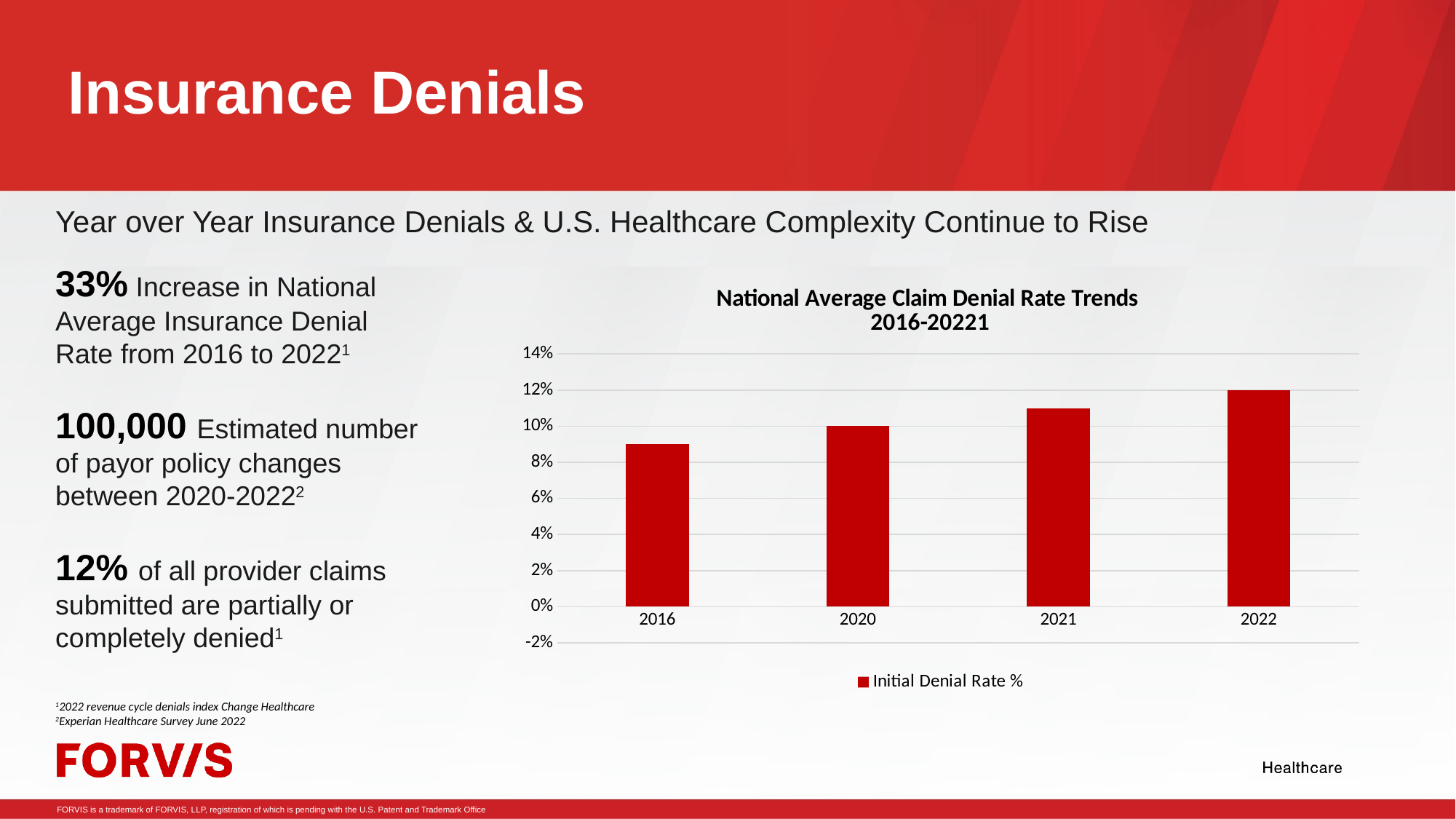
What is the title of the chart? National Average Claim Denial Rate Trends 2016-2022 What is the Initial Denial Rate % for 2020? 10% How many series does the chart legend list? 1 Does the Initial Denial Rate % rise or fall from 2016 to 2022? Rise Which year has the highest Initial Denial Rate %? 2022 What is the name of the series shown in the chart legend? Initial Denial Rate % Which year has the lowest Initial Denial Rate %? 2016 Is the Initial Denial Rate % for 2021 greater or less than 10%? greater Is the Initial Denial Rate % for 2016 greater or less than 10%? less How many years are plotted on the x axis of the chart? 4 What is the Initial Denial Rate % for 2022? 12% What kind of chart is shown on the slide? Bar chart